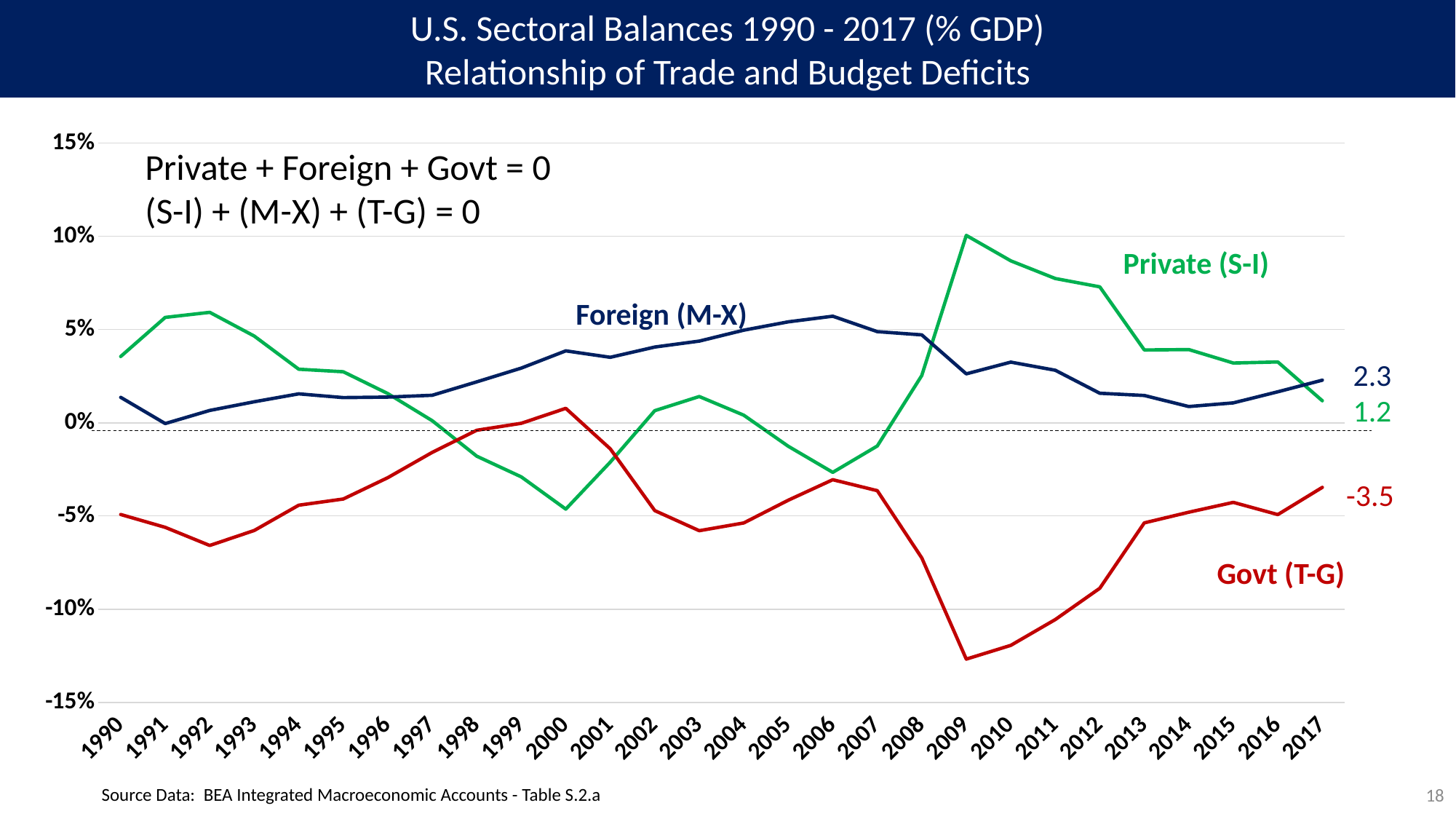
What kind of chart is shown on the slide? Line chart In 2017, which is larger: the Foreign (M-X) value or the Private (S-I) value? Foreign (M-X) What is the difference between the Foreign (M-X) and Private (S-I) values in 2017? 1.1 In which year does the Govt (T-G) series reach its lowest value? 2009 Does the Private (S-I) series rise or fall from 2009 to 2017? Fall How many data series are plotted on the chart? 3 Is the Govt (T-G) value in 2009 greater or less than -10%? less What is the value of the Foreign (M-X) series in 2017? 2.3 What is the value of the Private (S-I) series in 2017? 1.2 In which year does the Private (S-I) series reach its highest value? 2009 What is the value of the Govt (T-G) series in 2017? -3.5 How many years are shown along the x axis of the chart? 28